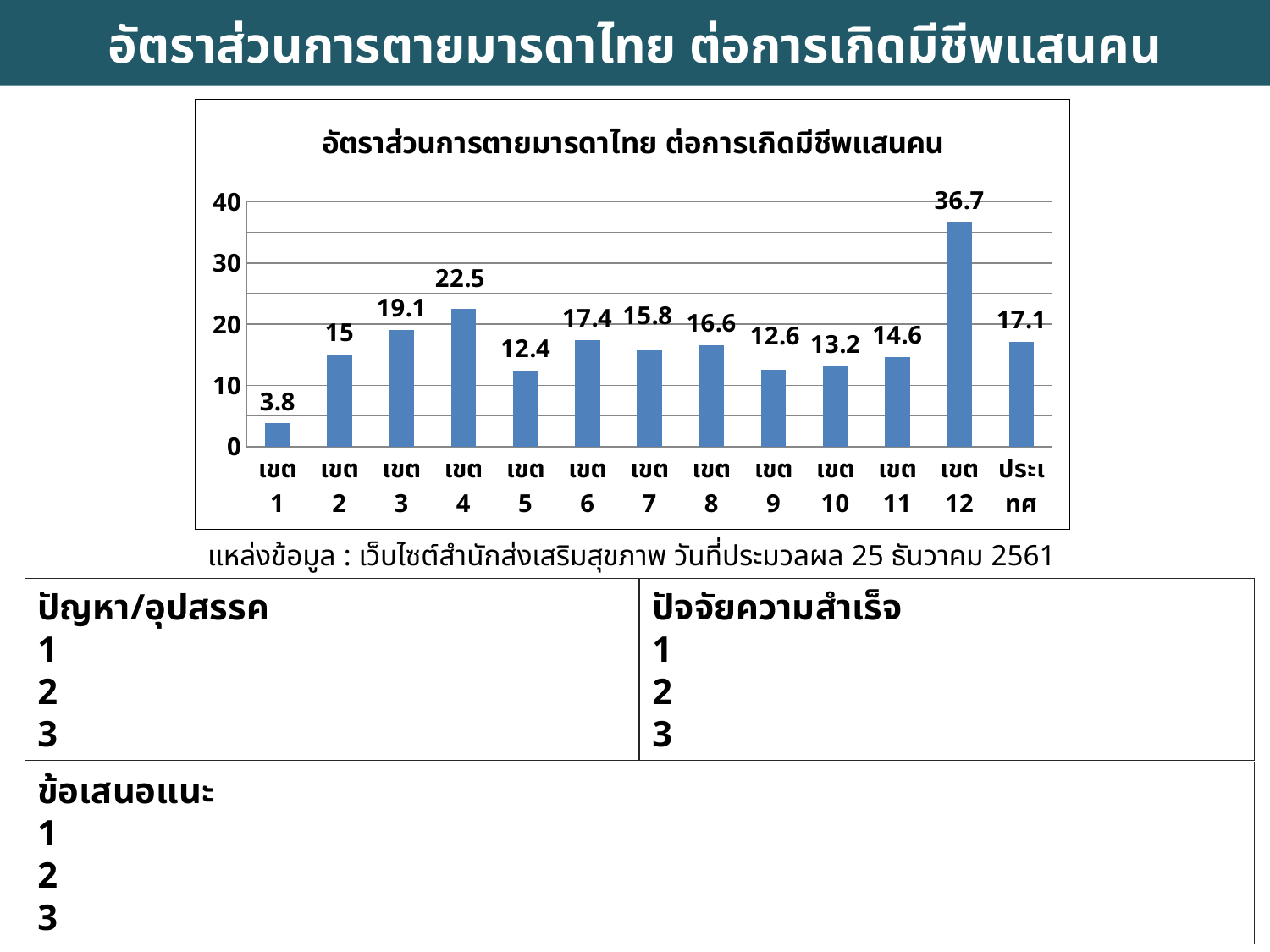
Which is larger, the value for เขต 6 or the value for เขต 7? เขต 6 Is the value for เขต 4 greater or less than 20? greater What is the value for เขต 5? 12.4 What is the value for ประเทศ? 17.1 Which category has the highest value? เขต 12 What is the value for เขต 12? 36.7 What is the difference between the values for เขต 4 and เขต 3? 3.4 How many categories are shown on the x axis? 13 Which category has the lowest value? เขต 1 What is the title of the chart? อัตราส่วนการตายมารดาไทย ต่อการเกิดมีชีพแสนคน What is the difference between the values for เขต 12 and เขต 1? 32.9 What kind of chart is shown on the slide? bar chart